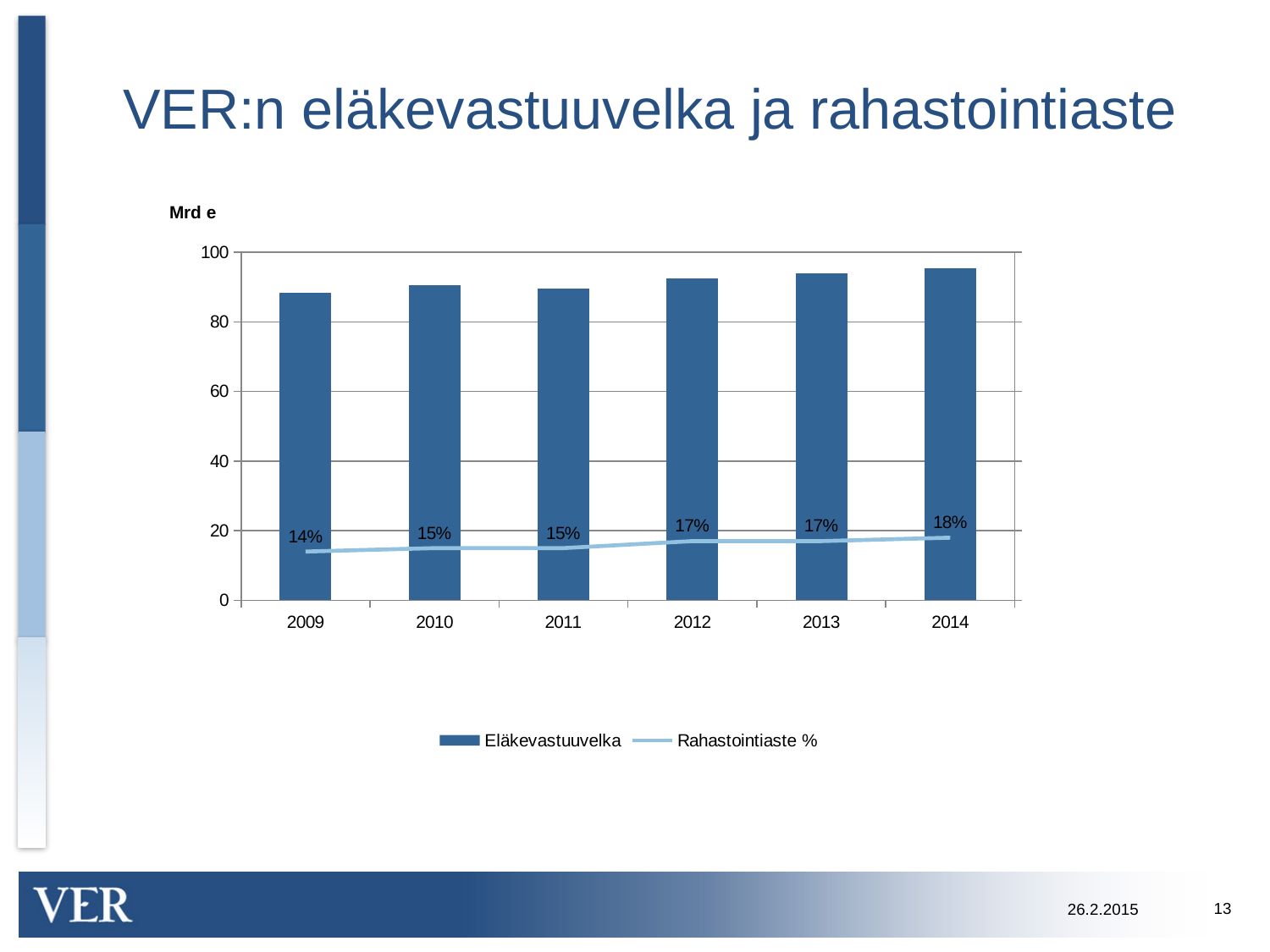
Is the Eläkevastuuvelka value for 2009 greater or less than 80? greater Which year has a higher Rahastointiaste %, 2010 or 2013? 2013 What is the Rahastointiaste % value for 2014? 18% In which year is the Rahastointiaste % highest? 2014 What is the Rahastointiaste % value for 2012? 17% By how many percentage points did the Rahastointiaste % rise from 2009 to 2014? 4 percentage points Is the Eläkevastuuvelka value for 2014 greater or less than 100? less In which year is the Rahastointiaste % lowest? 2009 How many series does the legend list? 2 What unit label is shown above the vertical axis? Mrd e How many years are shown on the x axis? 6 What is the Rahastointiaste % value for 2009? 14%